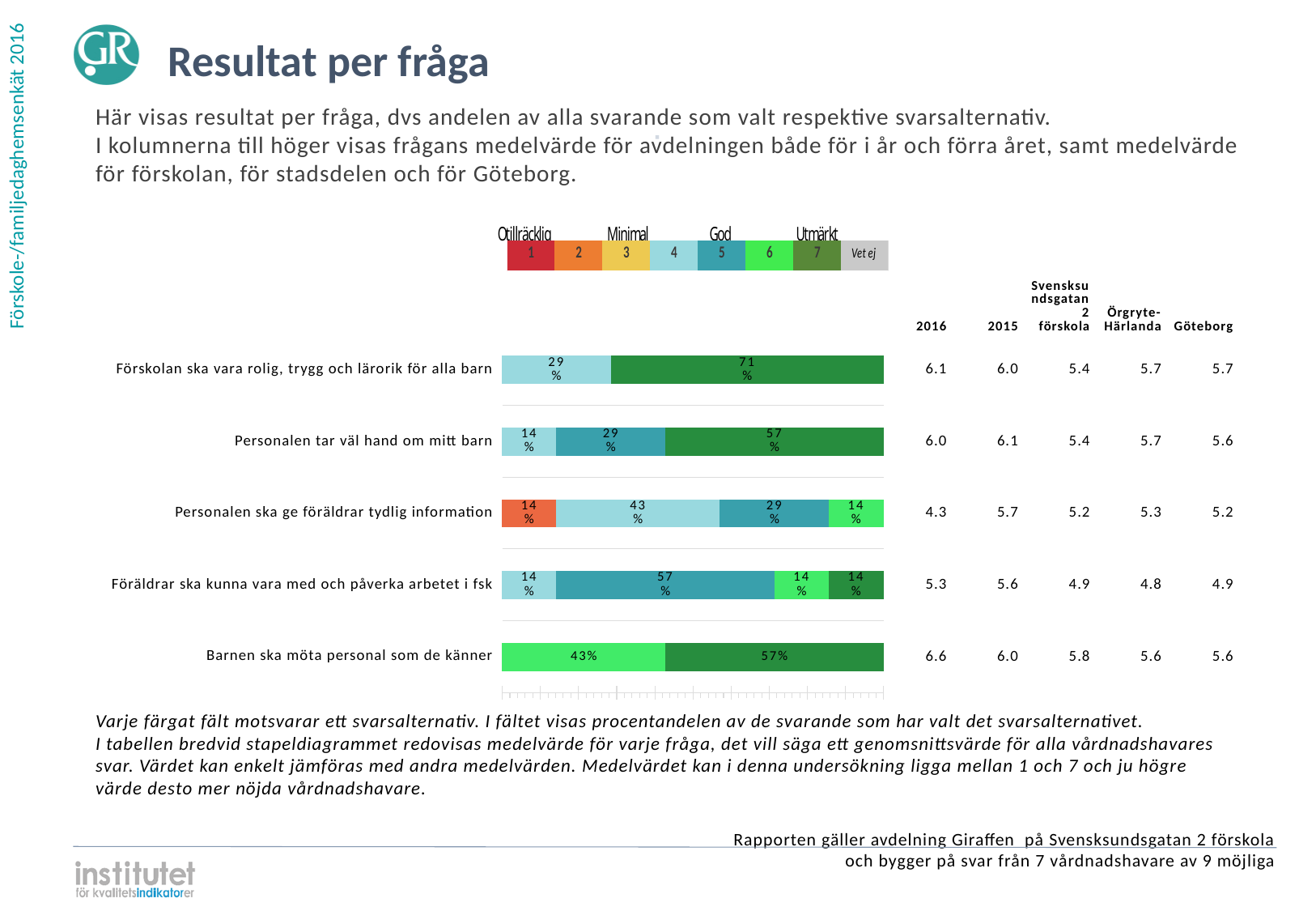
For 'Barnen ska möta personal som de känner', what is the difference between the share choosing 7 and the share choosing 6? 14% Which answer alternative has the largest share for 'Föräldrar ska kunna vara med och påverka arbetet i fsk'? 5 (57%) What percentage of respondents chose answer 5 (teal) for 'Personalen tar väl hand om mitt barn'? 29% How many questions (categories) are shown as bars in the chart? 5 What percentage of respondents chose answer 4 (light blue) for 'Personalen ska ge föräldrar tydlig information'? 43% Is the share choosing answer 7 larger for 'Personalen tar väl hand om mitt barn' or for 'Föräldrar ska kunna vara med och påverka arbetet i fsk'? Personalen tar väl hand om mitt barn What kind of chart is used to show the results per question? stacked bar chart What is the Göteborg mean value for 'Barnen ska möta personal som de känner'? 5.6 What percentage of respondents chose answer 7 (dark green) for 'Förskolan ska vara rolig, trygg och lärorik för alla barn'? 71% How many entries does the colour legend above the chart list (including 'Vet ej')? 8 What is the 2016 mean value for 'Personalen ska ge föräldrar tydlig information'? 4.3 Which question has the largest share of respondents choosing answer 7? Förskolan ska vara rolig, trygg och lärorik för alla barn